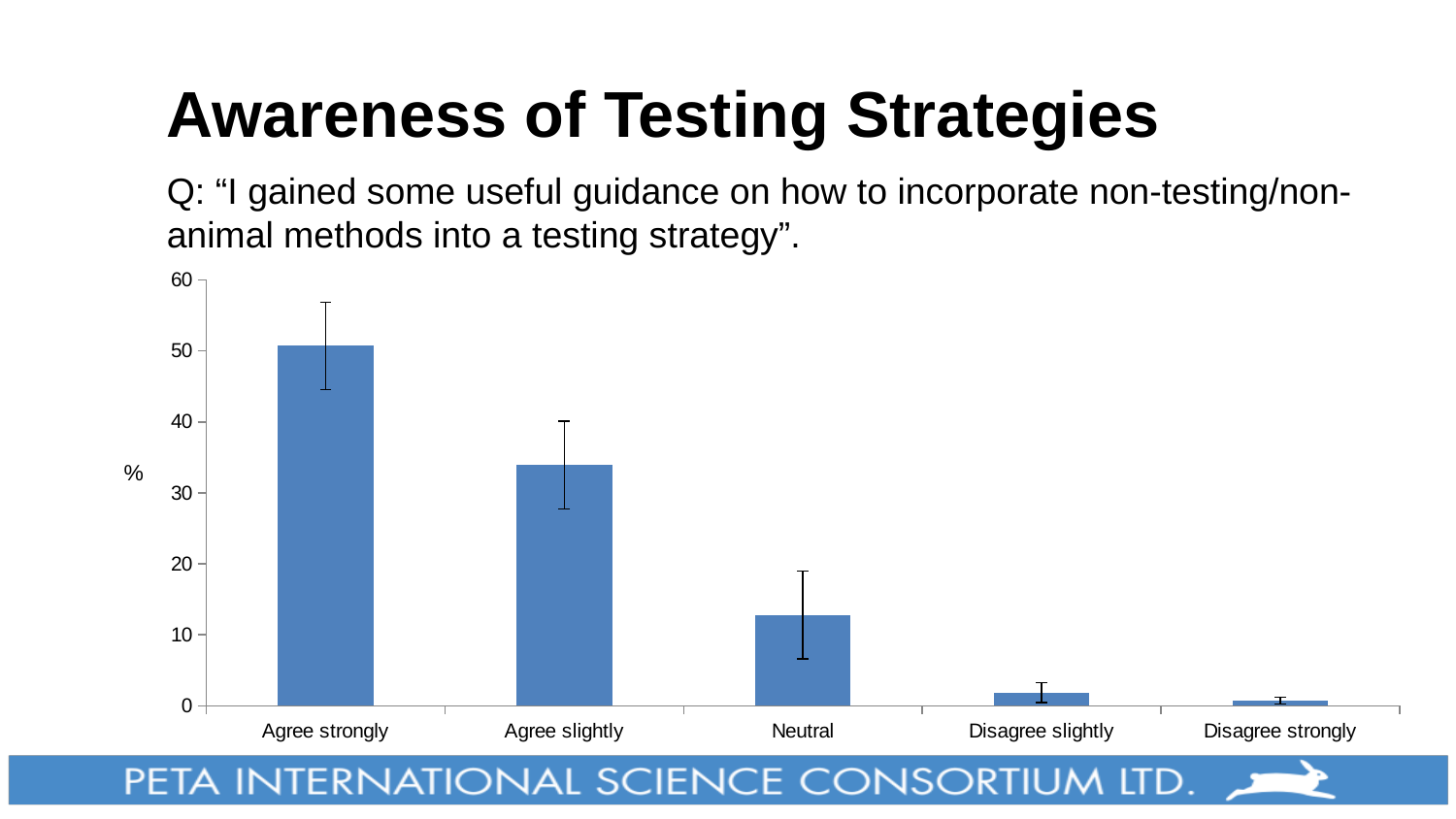
Which category has the lowest value in the chart? Disagree strongly Is the value for Agree slightly greater or less than 40? less Which is larger, the value for Agree slightly or the value for Neutral? Agree slightly Is the value for Neutral greater or less than 20? less Which category has the highest value in the chart? Agree strongly Is the value for Agree slightly greater or less than 30? greater Do the values rise or fall moving from Agree strongly to Disagree strongly along the x axis? fall What label is shown on the vertical axis of the chart? % What kind of chart is shown on the slide? bar chart How many categories are shown on the x axis of the chart? 5